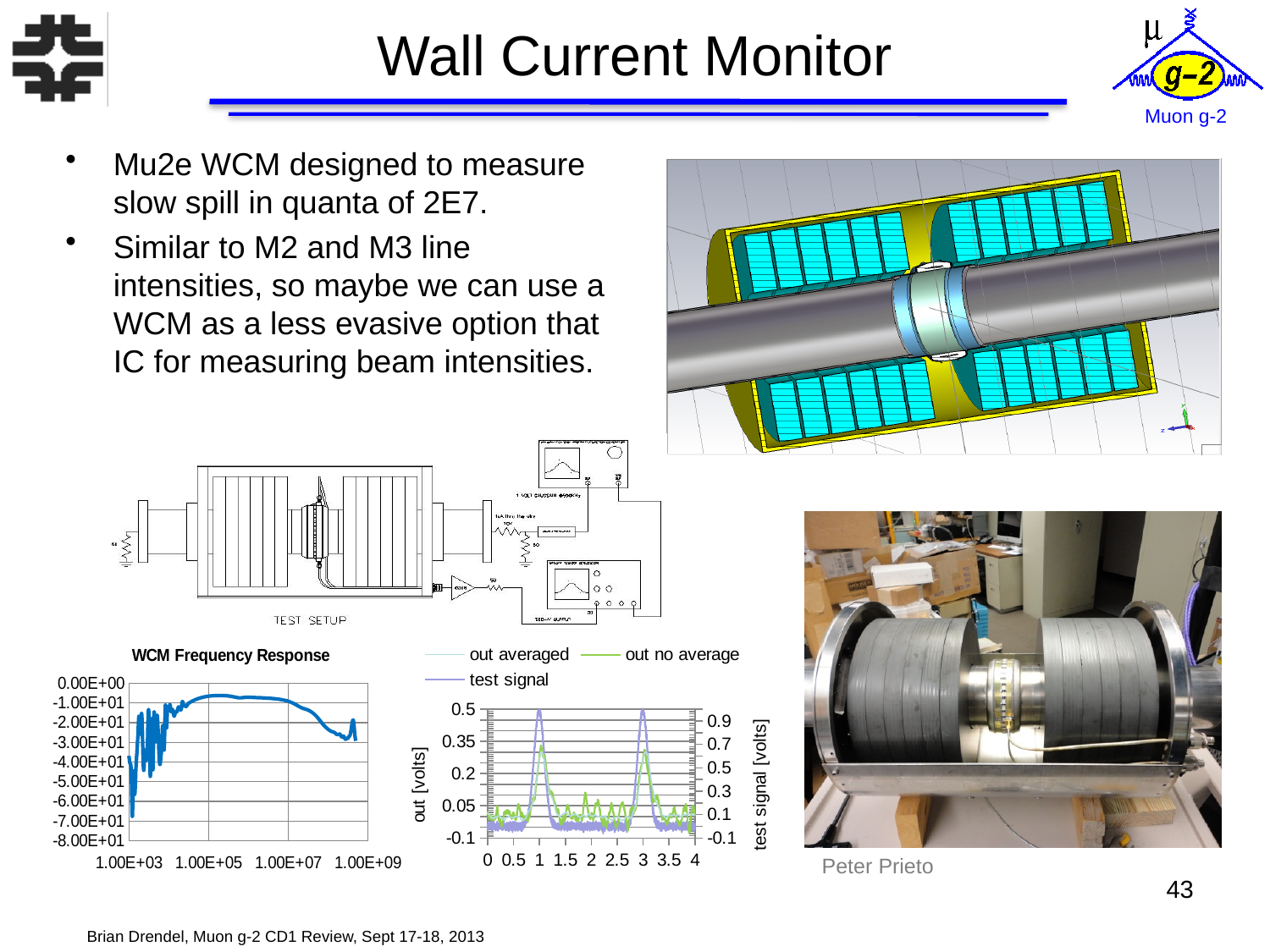
How many series does the legend of the chart to the right of the WCM Frequency Response chart list? 3 What kind of chart is the WCM Frequency Response chart? line chart In the WCM Frequency Response chart, does the curve rise or fall between 1.00E+03 and 1.00E+05? rise In the chart with the 'out [volts]' axis, is the 'out no average' value at x = 2 greater or less than 0.2 on the left-hand axis? less What is the lowest tick value on the vertical axis of the WCM Frequency Response chart? -8.00E+01 In the WCM Frequency Response chart, is the lowest point of the curve greater or less than -6.00E+01? less What are the legend entries of the chart with the 'out [volts]' axis? out averaged, out no average, test signal In the chart with the 'out [volts]' axis, is the peak of the test signal near x = 1 greater or less than 0.7 on the right-hand axis? greater In the WCM Frequency Response chart, does the curve rise or fall between 1.00E+07 and 1.00E+09? fall What is the highest tick value on the horizontal axis of the chart with the 'out [volts]' axis? 4